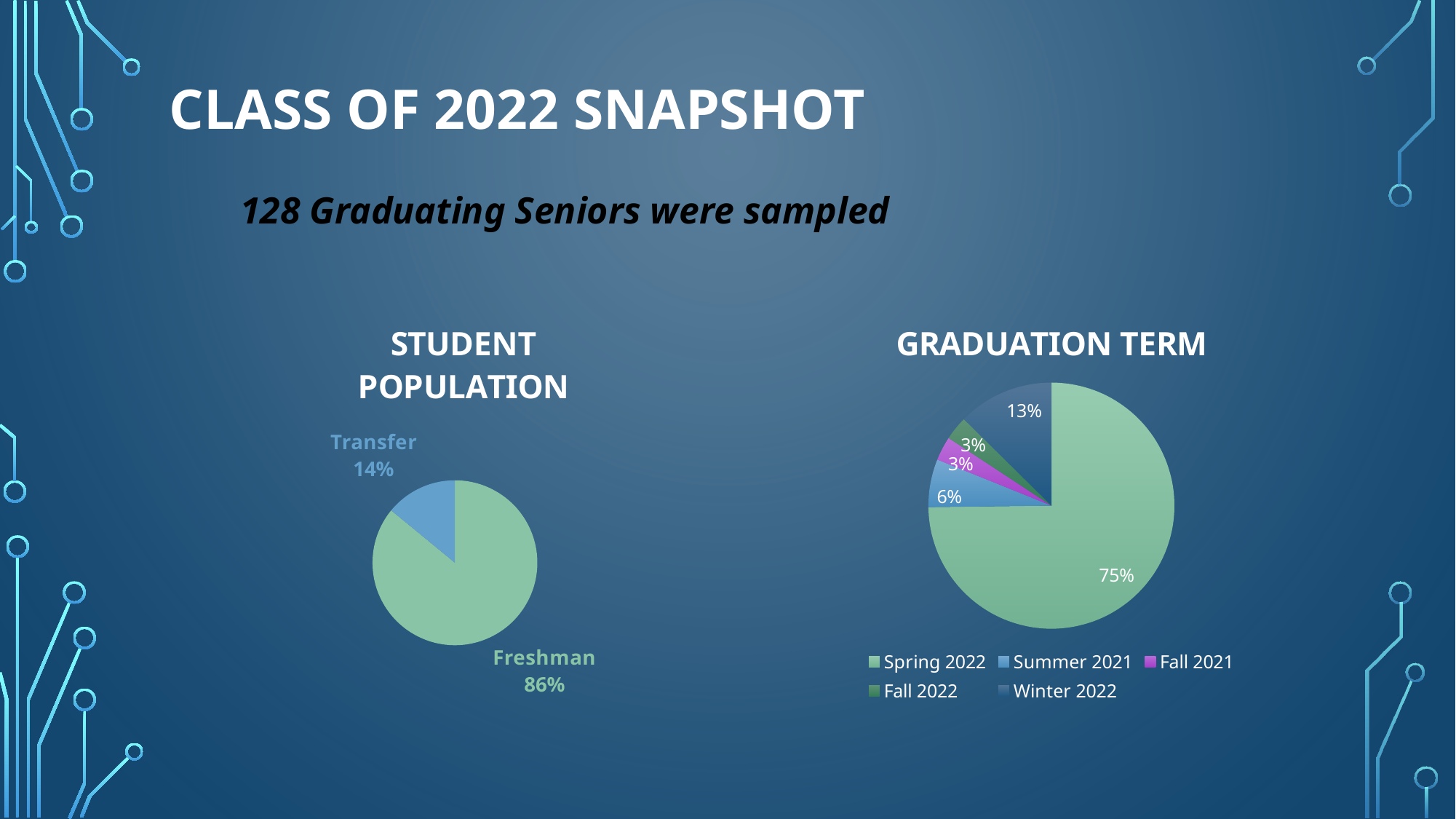
In the Student Population chart, which category has the larger share? Freshman How many categories does the legend of the Graduation Term chart list? 5 In the Student Population chart, what share of students are Freshman? 86% In the Graduation Term chart, what share of students graduated in Spring 2022? 75% In the Graduation Term chart, what share of students graduated in Summer 2021? 6% In the Graduation Term chart, what share of students graduated in Winter 2022? 13% In the Graduation Term chart, which is larger: the Winter 2022 share or the Summer 2021 share? Winter 2022 In the Student Population chart, what share of students are Transfer students? 14% In the Graduation Term chart, what is the difference between the Spring 2022 and Winter 2022 shares? 62% What kind of chart is the Student Population chart? Pie chart In the Graduation Term chart, which term has the largest share? Spring 2022 In the Student Population chart, what is the difference between the Freshman and Transfer shares? 72%